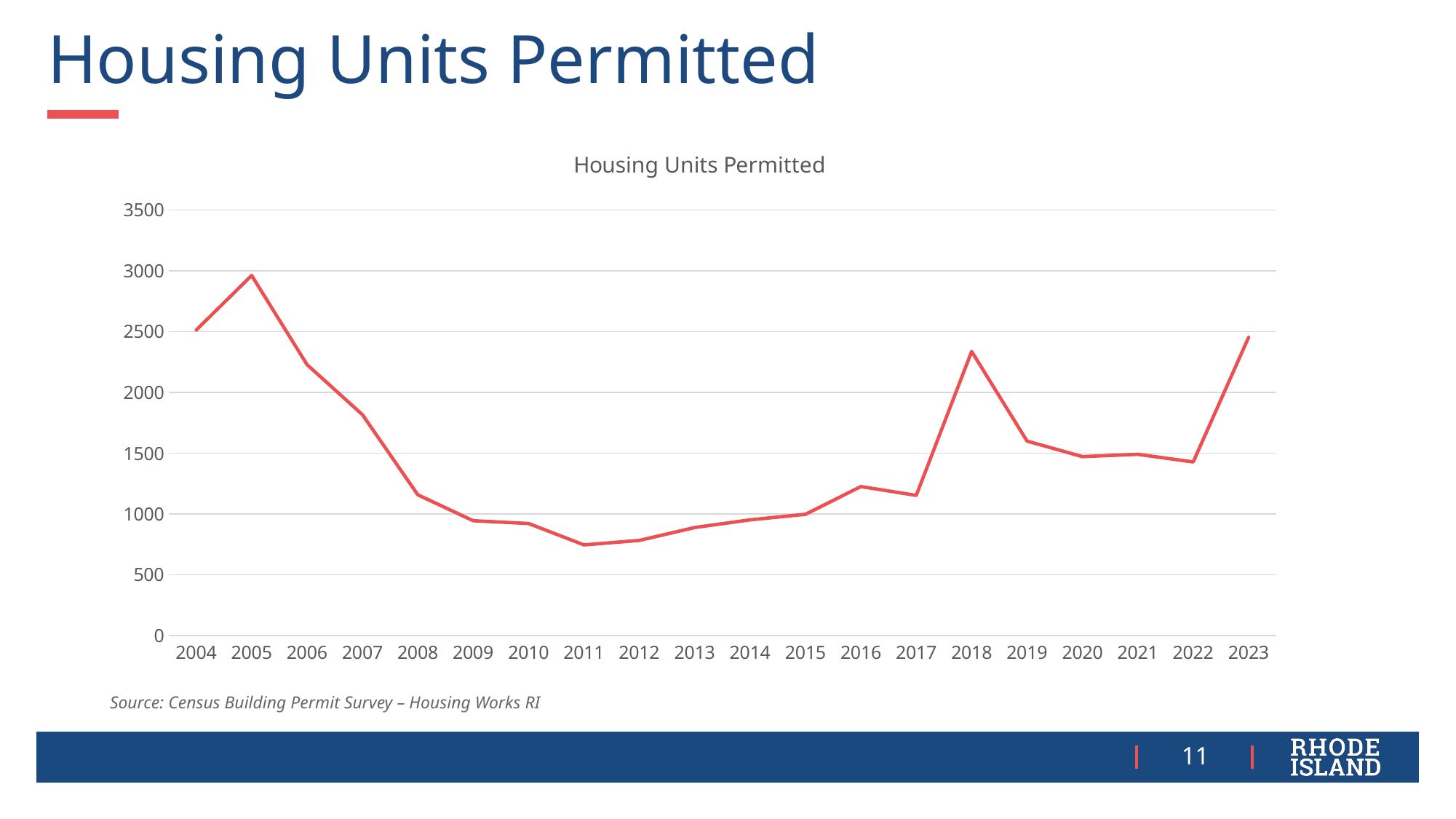
Which year has the lowest number of housing units permitted? 2011 Which year has the highest number of housing units permitted? 2005 What kind of chart is shown on the slide? line chart How many years are plotted on the x axis of the chart? 20 Do the values rise or fall from 2005 to 2011? fall Is the value for 2011 greater or less than 1000? less Is the value for 2005 greater or less than 2500? greater Is the value for 2006 greater or less than 2000? greater What is the title of the chart? Housing Units Permitted Which year has a higher value, 2004 or 2008? 2004 Which year has a higher value, 2018 or 2019? 2018